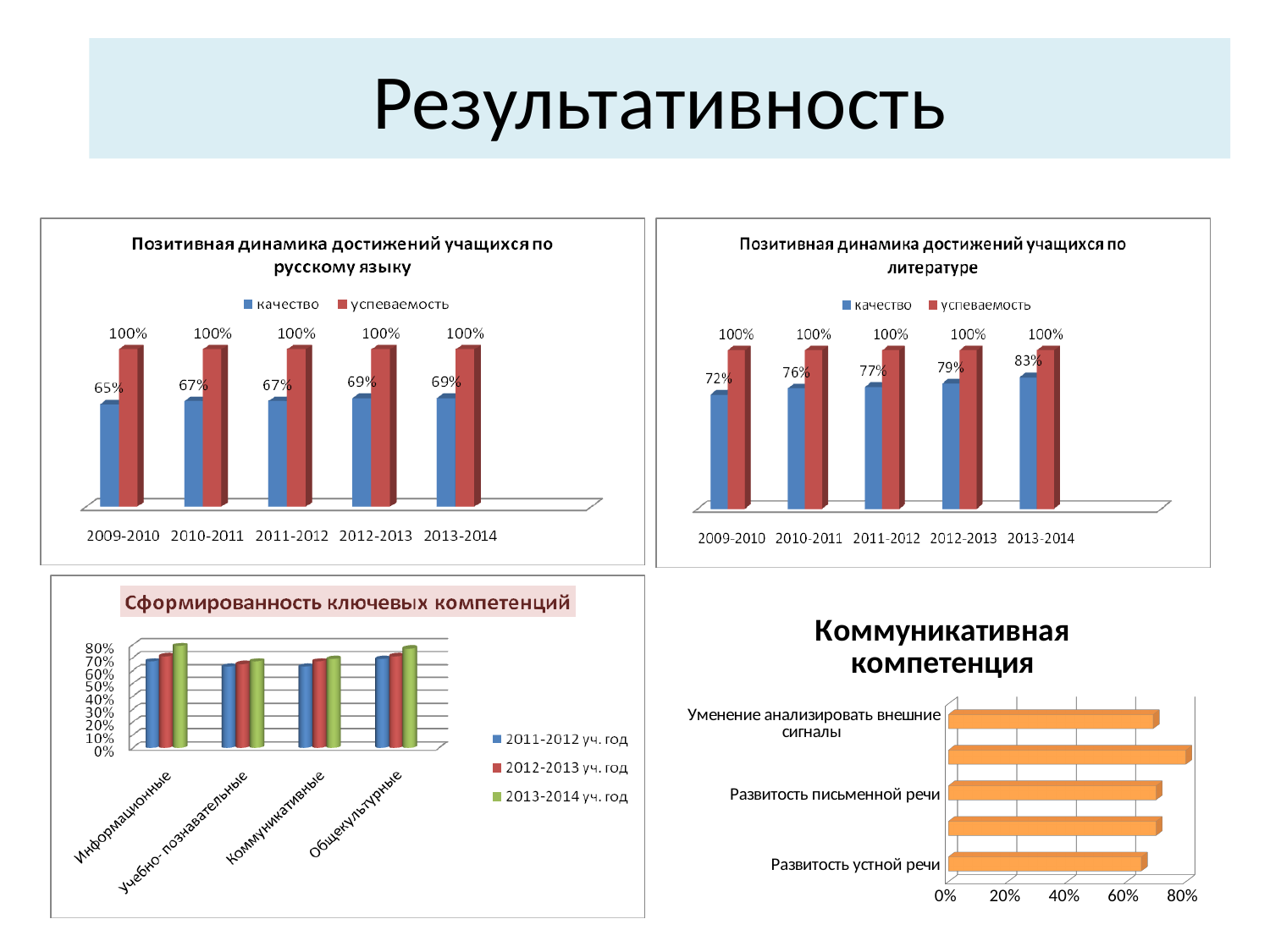
On the chart 'Позитивная динамика достижений учащихся по литературе', which year has the lowest качество value? 2009-2010 On the chart 'Позитивная динамика достижений учащихся по литературе', what is the value of качество for 2011-2012? 77% On the chart 'Позитивная динамика достижений учащихся по русскому языку', what is the difference between успеваемость and качество for 2010-2011? 33% On the chart 'Позитивная динамика достижений учащихся по русскому языку', what is the value of качество for 2013-2014? 69% On the chart 'Сформированность ключевых компетенций', how many series does the legend list? 3 On the chart 'Позитивная динамика достижений учащихся по литературе', what is the difference in качество between 2013-2014 and 2009-2010? 11% On the chart 'Позитивная динамика достижений учащихся по русскому языку', what is the value of качество for 2009-2010? 65% What kind of chart is 'Коммуникативная компетенция'? bar chart On the chart 'Позитивная динамика достижений учащихся по литературе', does the качество value rise or fall from 2009-2010 to 2013-2014? rise On the chart 'Позитивная динамика достижений учащихся по русскому языку', how many series does the legend list? 2 On the chart 'Сформированность ключевых компетенций', how many categories are shown on the x axis? 4 On the chart 'Позитивная динамика достижений учащихся по литературе', which year has the highest качество value? 2013-2014